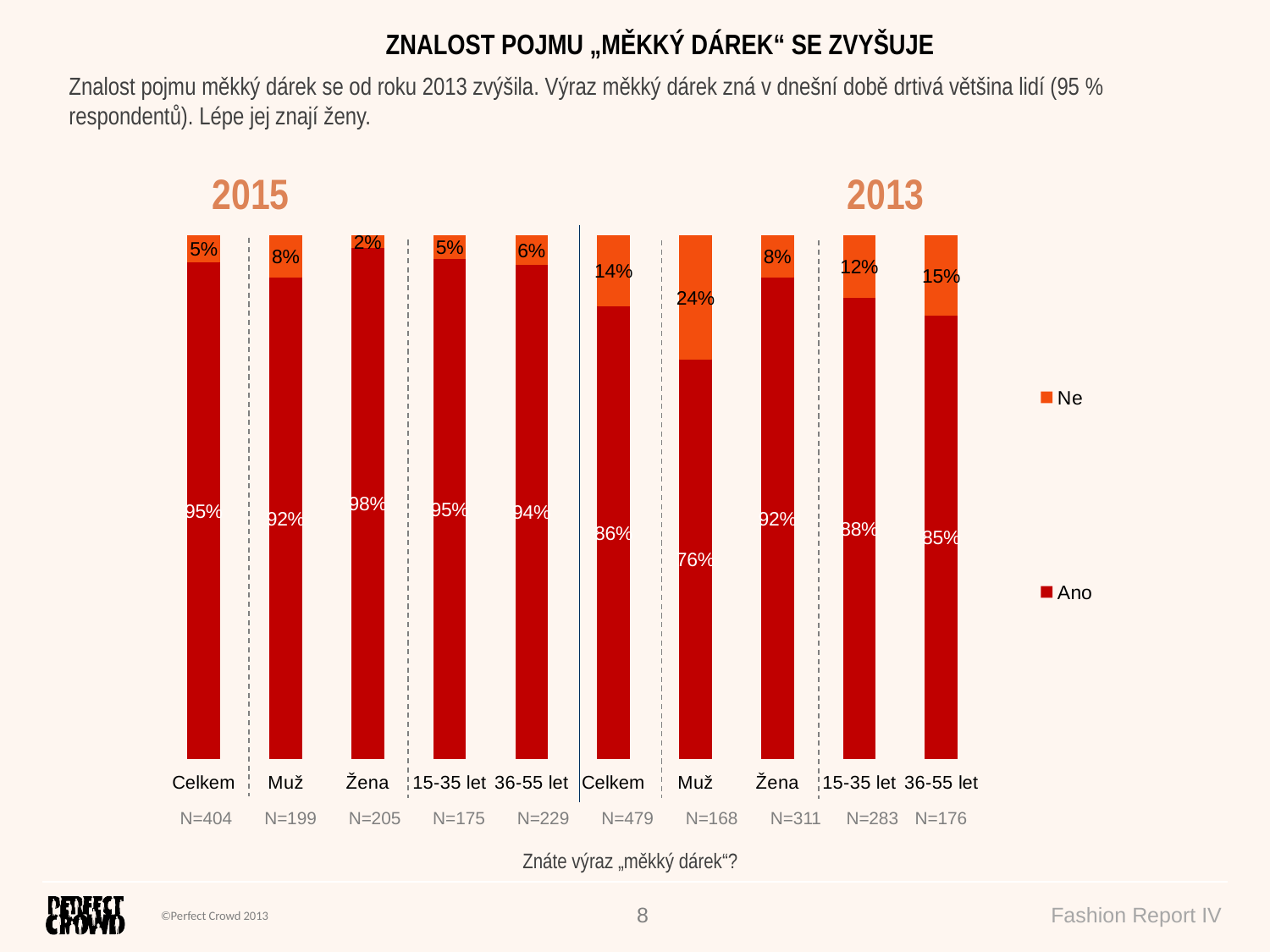
How many series does the legend list? 2 What kind of chart is shown on the slide? Stacked bar chart What is the "Ano" value for Žena in the 2015 group? 98% What is the sample size (N) shown for Celkem in the 2013 group? N=479 What is the "Ano" value for Celkem in the 2015 group? 95% What is the "Ne" value for 36-55 let in the 2013 group? 15% What is the "Ne" value for Muž in the 2013 group? 24% What is the difference between the "Ano" value for Muž in 2015 and the "Ano" value for Muž in 2013? 16% What is the total of the stacked bar for 15-35 let in the 2013 group? 100% Which category in the 2015 group has the lowest "Ne" value? Žena Which category in the 2013 group has the highest "Ne" value? Muž Which is larger: the "Ano" value for Žena in 2013 or the "Ano" value for Celkem in 2013? Žena in 2013